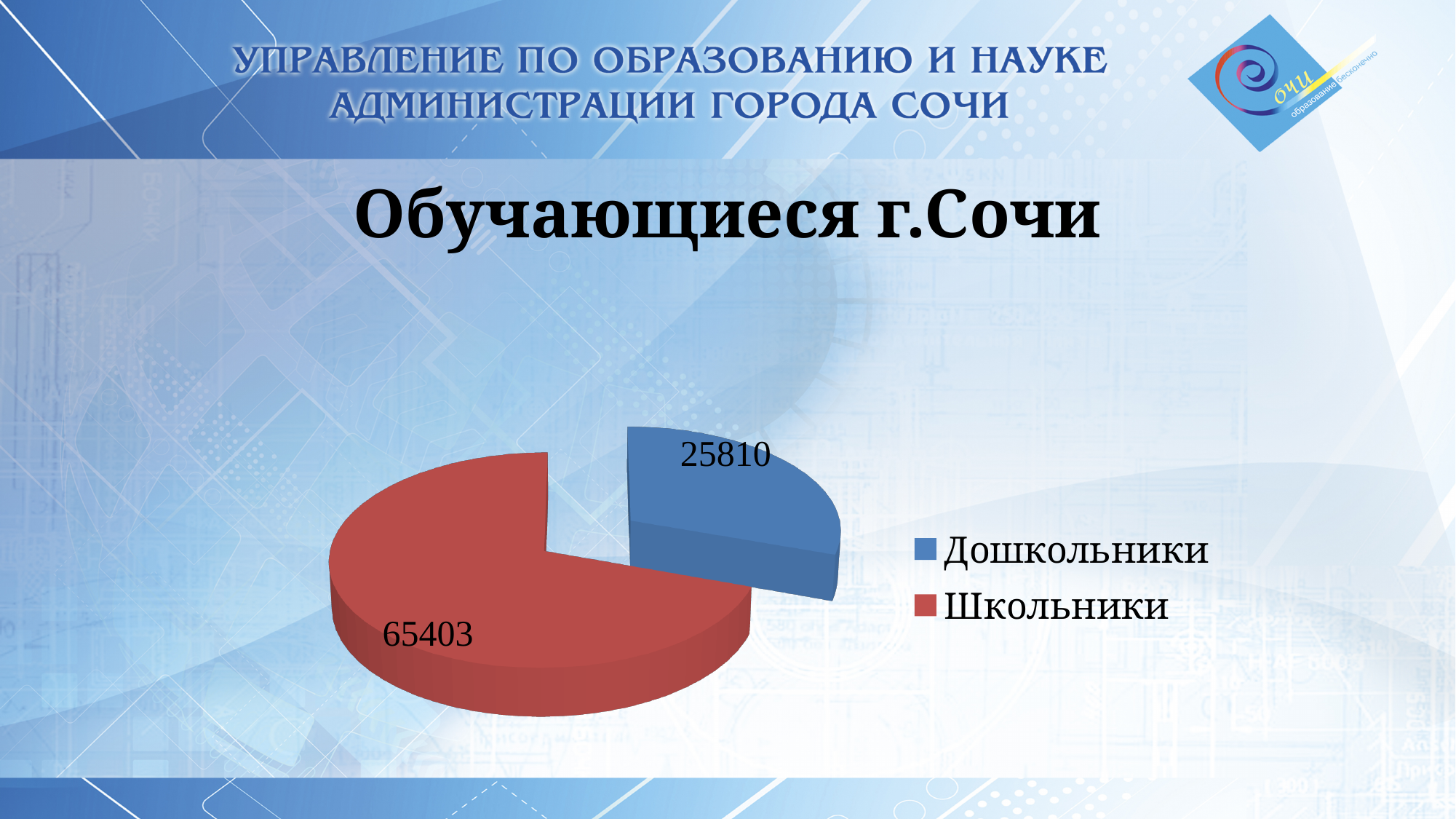
How many slices does the pie chart have? 2 Which is larger, the value for Школьники or the value for Дошкольники? Школьники What is the difference between the value for Школьники and the value for Дошкольники? 39593 What kind of chart is shown on the slide? pie chart What is the value for Школьники? 65403 Which category has the largest slice of the pie? Школьники Which category has the smallest slice of the pie? Дошкольники How many entries does the legend list? 2 What is the title of the chart on the slide? Обучающиеся г.Сочи What is the value for Дошкольники? 25810 What is the total of the two values shown in the pie chart? 91213 What colour is the slice for Школьники? red